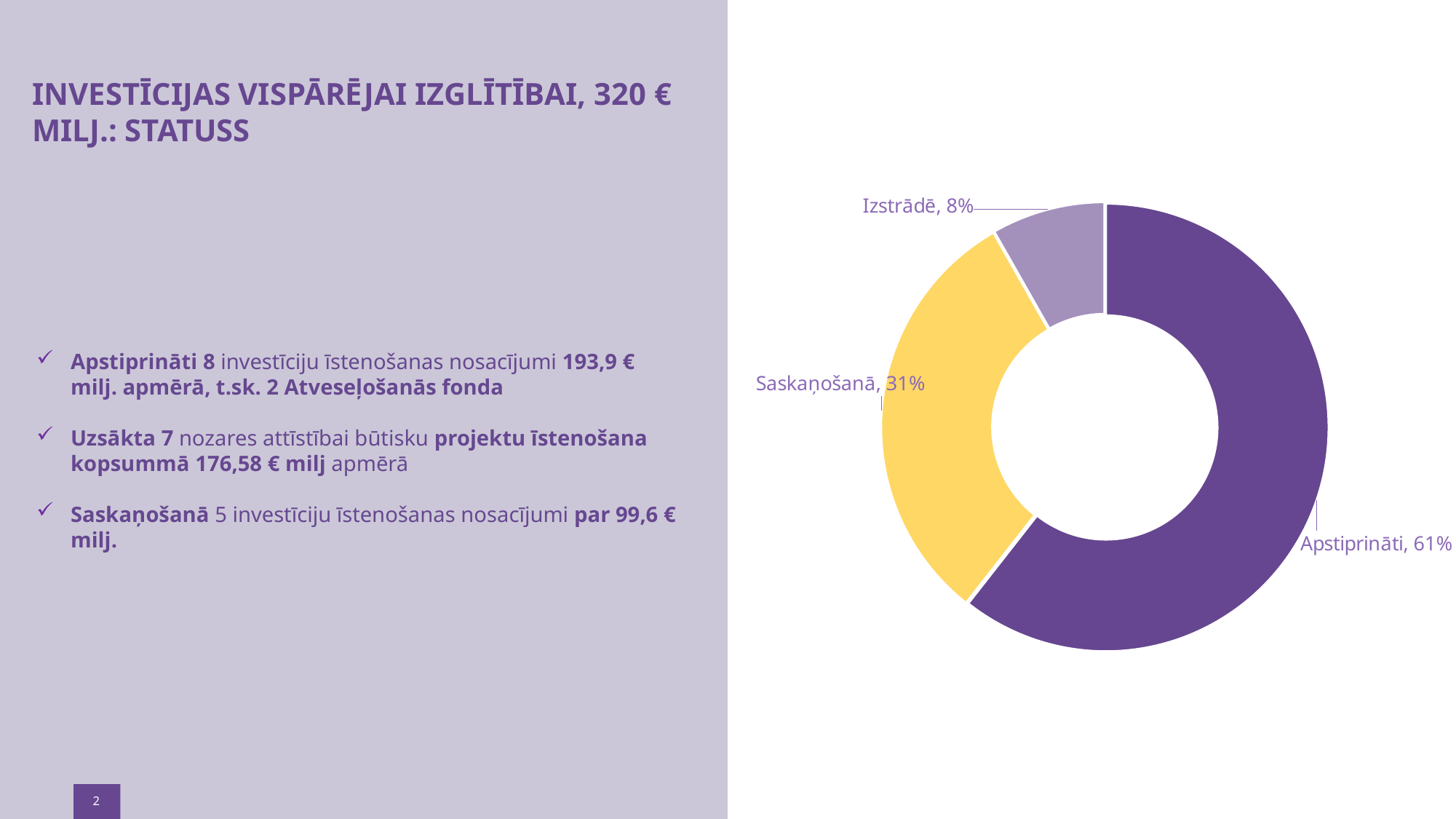
Which slice is larger, Saskaņošanā or Izstrādē? Saskaņošanā What colour is the Saskaņošanā slice? Yellow What share of the doughnut chart does Apstiprināti represent? 61% What share of the doughnut chart does Saskaņošanā represent? 31% What is the difference in percentage points between the Saskaņošanā and Izstrādē slices? 23 What is the difference in percentage points between the Apstiprināti and Saskaņošanā slices? 30 Which category has the largest slice in the chart? Apstiprināti What type of chart is shown on the slide? Doughnut chart What colour is the Apstiprināti slice? Dark purple What share of the doughnut chart does Izstrādē represent? 8% Which category has the smallest slice in the chart? Izstrādē How many categories are shown in the chart? 3